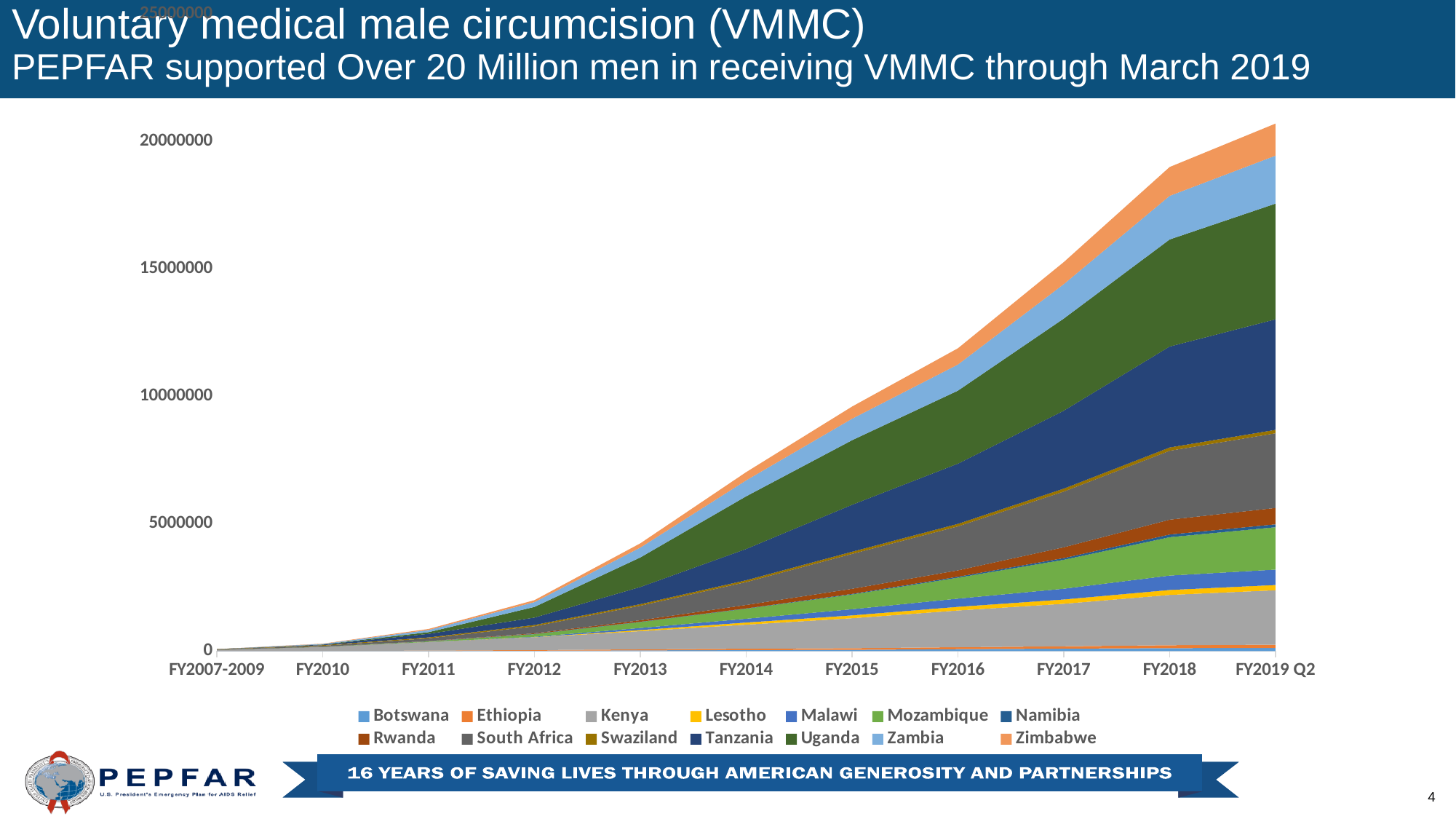
Is the total stacked value for FY2016 greater or less than 10000000? greater Is the total stacked value for FY2014 greater or less than 10000000? less Is the total stacked value for FY2019 Q2 greater or less than 20000000? greater How many countries does the legend list? 14 What is the label of the first category on the x axis? FY2007-2009 How many fiscal-year periods are shown along the x axis? 11 Which period on the x axis has the lowest total stacked value? FY2007-2009 Do the cumulative VMMC totals rise or fall from FY2007-2009 to FY2019 Q2? Rise What kind of chart is shown on the slide? Stacked area chart Which period on the x axis has the highest total stacked value? FY2019 Q2